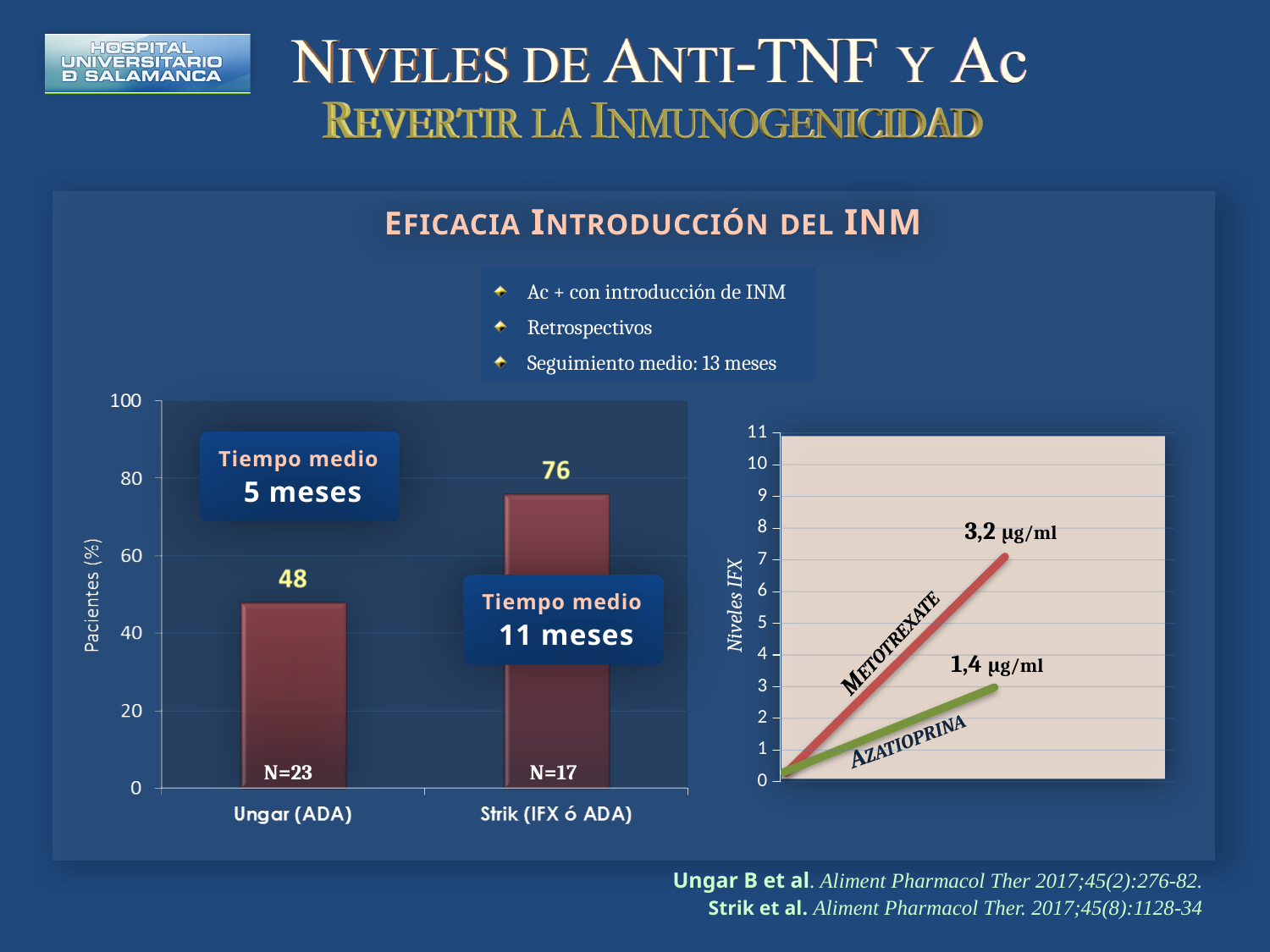
In the bar chart on the left, which category has the lowest value? Ungar (ADA) In the bar chart on the left, which category has the highest value? Strik (IFX ó ADA) In the bar chart on the left, what is the difference between the values for Strik (IFX ó ADA) and Ungar (ADA)? 28 In the bar chart on the left, what is the N value printed on the Ungar (ADA) bar? N=23 In the bar chart on the left, is the value for Ungar (ADA) greater or less than 60? less What kind of chart is shown on the left of the slide? bar chart In the bar chart on the left, what is the value for Strik (IFX ó ADA)? 76 In the chart on the right (Niveles IFX), what value is labelled at the end of the Metotrexate line? 3,2 µg/ml In the chart on the right (Niveles IFX), which line reaches a higher value, Metotrexate or Azatioprina? Metotrexate In the bar chart on the left, what is the value for Ungar (ADA)? 48 In the chart on the right (Niveles IFX), what value is labelled at the end of the Azatioprina line? 1,4 µg/ml In the bar chart on the left, how many categories are shown on the x axis? 2